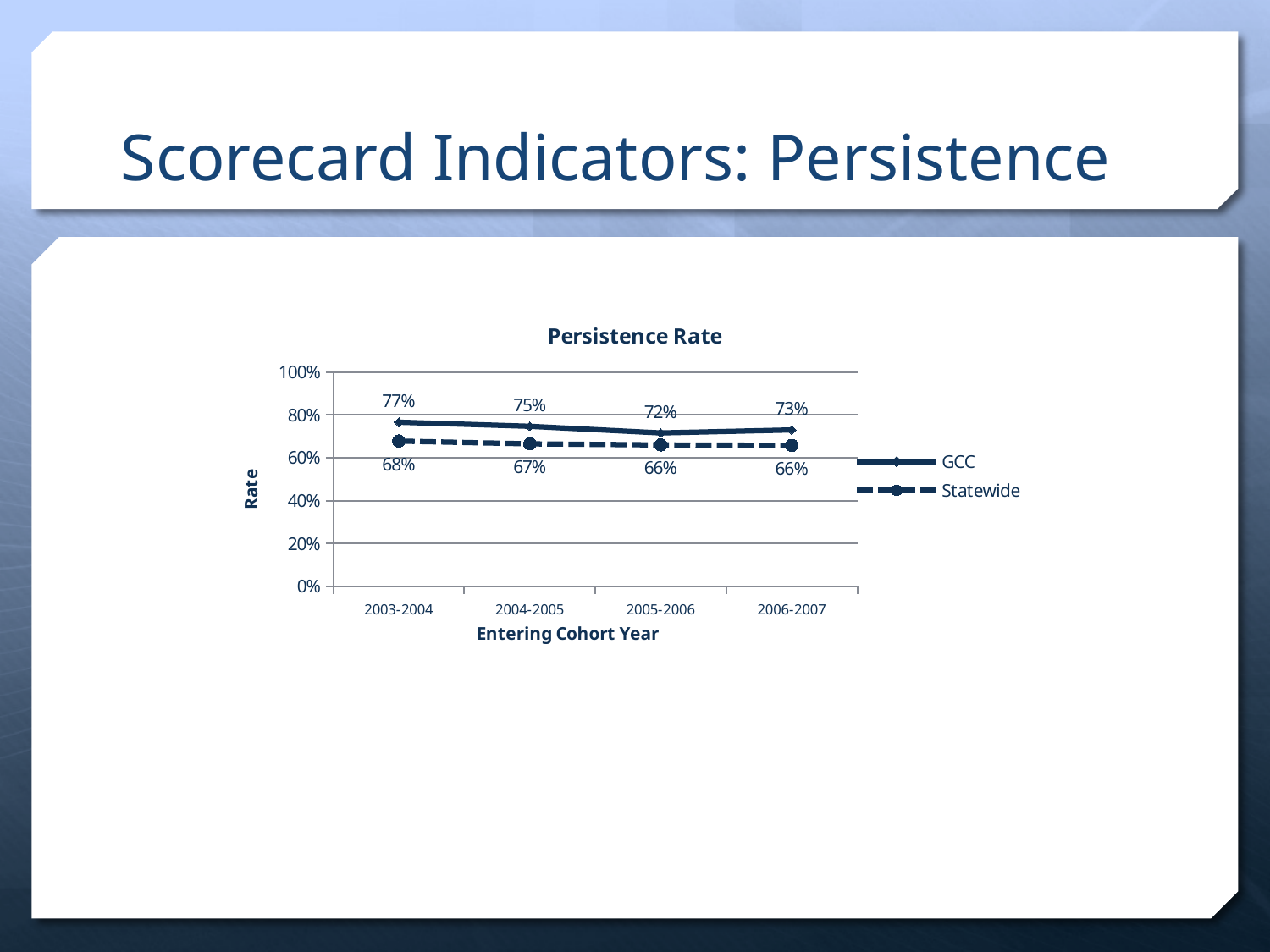
What is the GCC persistence rate for the 2003-2004 entering cohort? 77% What is the title of the chart? Persistence Rate How many entering cohort years are shown on the x axis? 4 Is the Statewide persistence rate for the 2003-2004 cohort greater or less than 80%? less Which entering cohort year has the highest GCC persistence rate? 2003-2004 How many series does the legend list? 2 What is the difference between the GCC and Statewide persistence rates for the 2004-2005 cohort? 8% What is the Statewide persistence rate for the 2005-2006 entering cohort? 66% Which series has the higher persistence rate for the 2006-2007 cohort, GCC or Statewide? GCC Which entering cohort year has the lowest GCC persistence rate? 2005-2006 What kind of chart is shown on the slide? line chart What is the GCC persistence rate for the 2006-2007 entering cohort? 73%